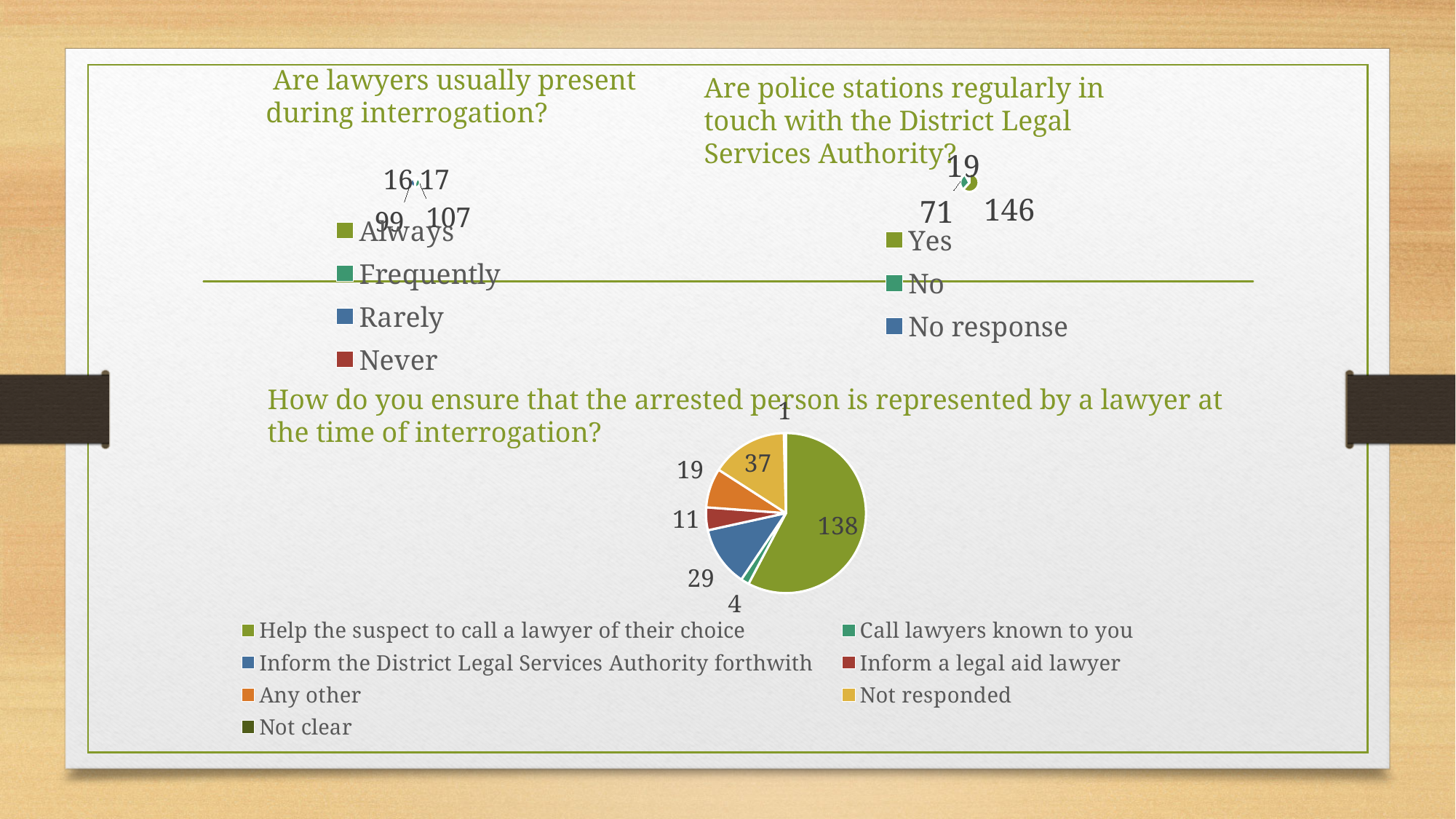
On the chart titled 'How do you ensure that the arrested person is represented by a lawyer at the time of interrogation?', which is larger: 'Any other' or 'Inform a legal aid lawyer'? Any other On the chart titled 'How do you ensure that the arrested person is represented by a lawyer at the time of interrogation?', what is the value for 'Inform the District Legal Services Authority forthwith'? 29 On the chart titled 'How do you ensure that the arrested person is represented by a lawyer at the time of interrogation?', what is the value for 'Help the suspect to call a lawyer of their choice'? 138 What kind of chart is used for 'Are lawyers usually present during interrogation?'? Pie chart On the chart titled 'How do you ensure that the arrested person is represented by a lawyer at the time of interrogation?', what is the value for 'Any other'? 19 On the chart titled 'How do you ensure that the arrested person is represented by a lawyer at the time of interrogation?', which category has the smallest value? Not clear On the chart titled 'How do you ensure that the arrested person is represented by a lawyer at the time of interrogation?', what is the value for 'Not responded'? 37 On the chart titled 'How do you ensure that the arrested person is represented by a lawyer at the time of interrogation?', what is the difference between 'Not responded' and 'Inform the District Legal Services Authority forthwith'? 8 How many categories does the legend of the chart titled 'Are police stations regularly in touch with the District Legal Services Authority?' list? 3 How many categories does the legend of the chart titled 'How do you ensure that the arrested person is represented by a lawyer at the time of interrogation?' list? 7 On the chart titled 'How do you ensure that the arrested person is represented by a lawyer at the time of interrogation?', what is the value for 'Inform a legal aid lawyer'? 11 On the chart titled 'How do you ensure that the arrested person is represented by a lawyer at the time of interrogation?', which category has the largest slice? Help the suspect to call a lawyer of their choice